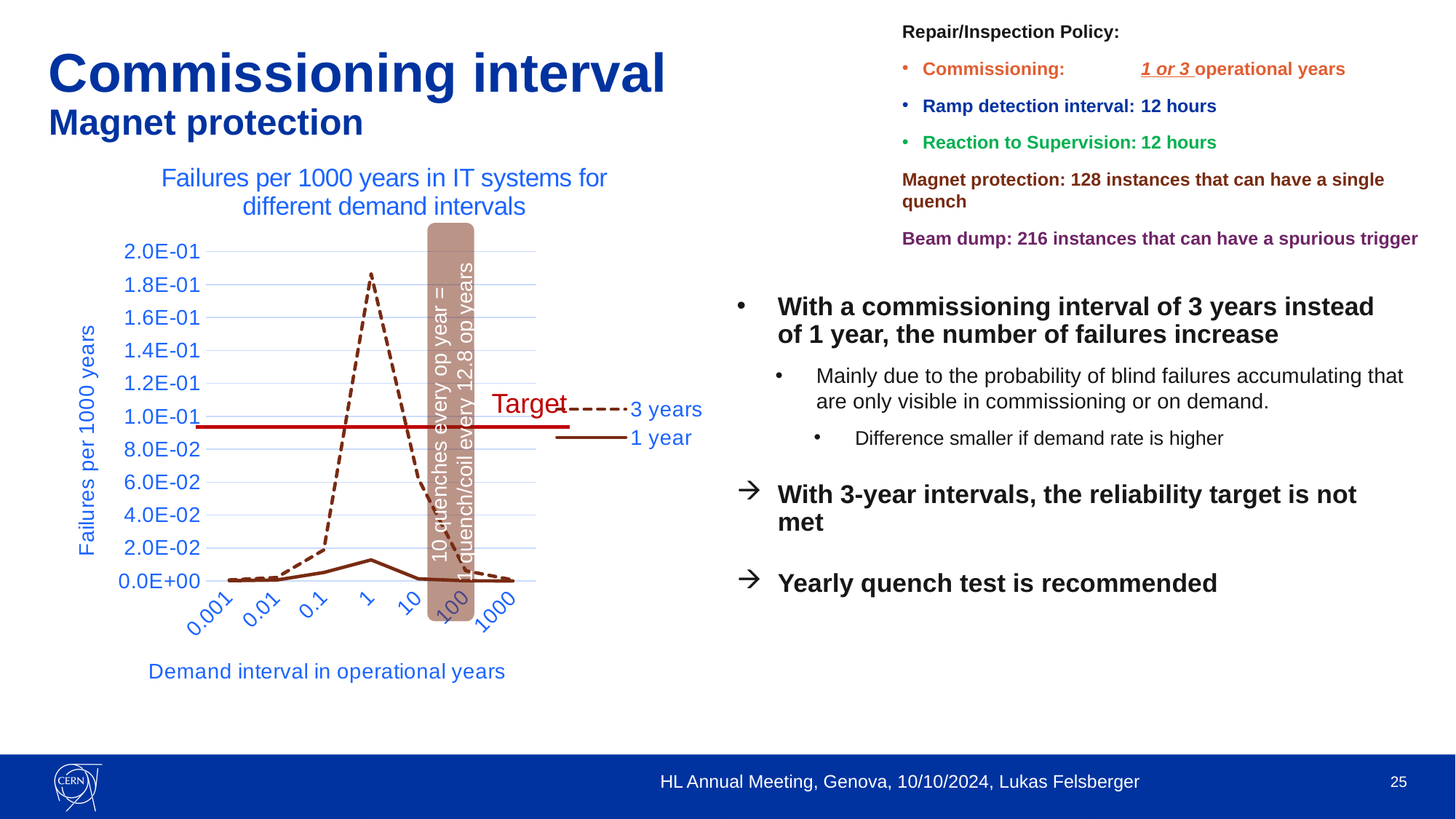
How many demand interval values are marked on the x axis of the chart? 7 Is the value of the 1 year series at a demand interval of 1 greater or less than 2.0E-02? less At which demand interval does the 1 year series reach its highest value? 1 Do the values of the 3 years series rise or fall as the demand interval increases from 1 to 1000? Fall Is the value of the 3 years series at a demand interval of 1 greater or less than 1.0E-01? greater At which demand interval does the 3 years series reach its highest value? 1 How many series does the chart legend list? 2 What kind of chart is shown on the slide? Line chart What is the title of the chart? Failures per 1000 years in IT systems for different demand intervals What is the label of the x axis of the chart? Demand interval in operational years Is the value of the 3 years series at a demand interval of 0.1 greater or less than 4.0E-02? less At a demand interval of 1 operational year, which series has the higher failure rate, 3 years or 1 year? 3 years